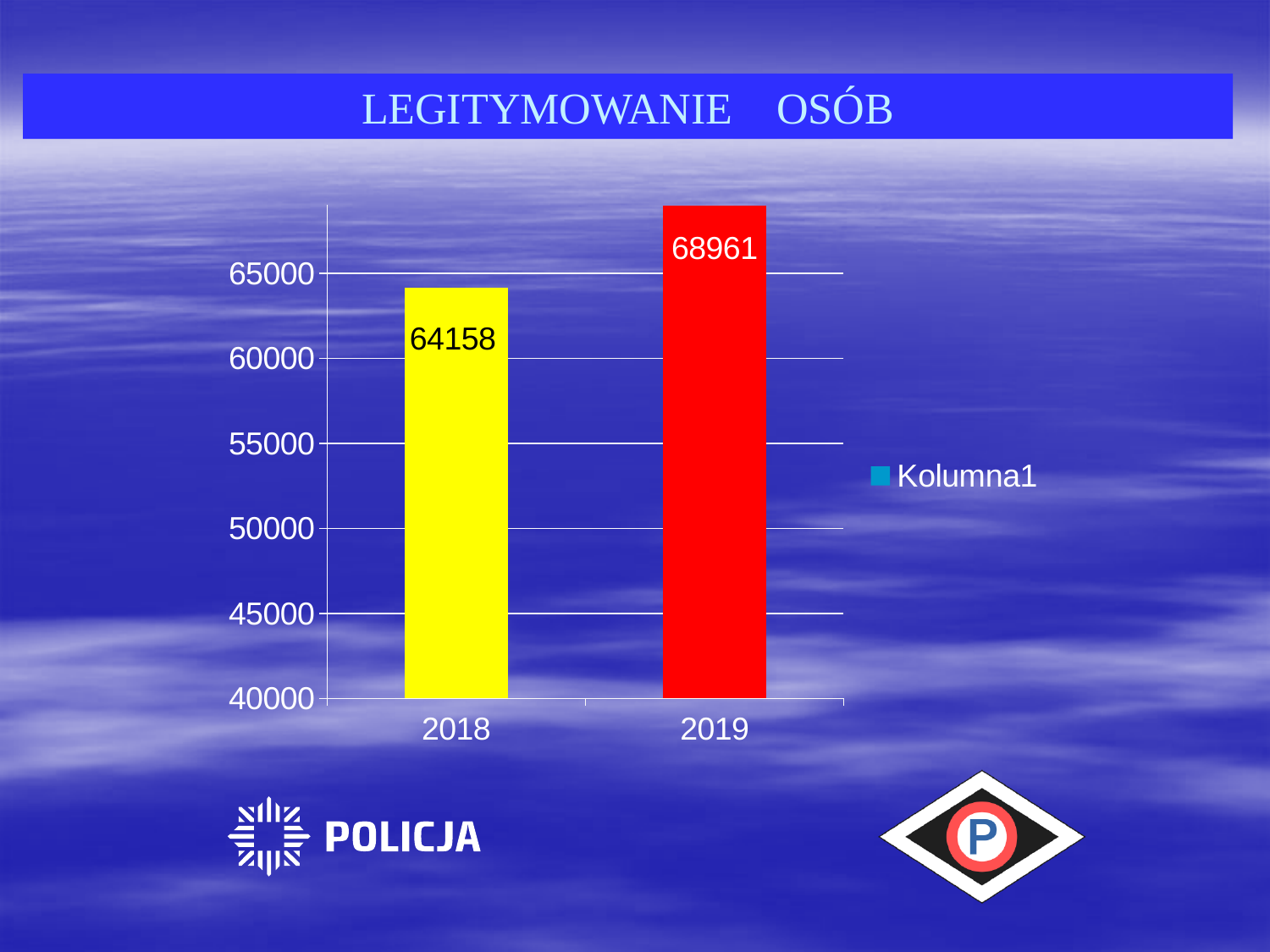
Which year has the lower value? 2018 Is the value for 2019 greater or less than 65000? greater Which year has the higher value? 2019 What is the title of the slide? LEGITYMOWANIE OSÓB What kind of chart is shown on the slide? bar chart Do the values rise or fall from 2018 to 2019? rise What is the difference between the 2019 and 2018 values? 4803 How many series does the legend list? 1 How many categories are shown on the x axis? 2 Is the value for 2018 greater or less than 65000? less What is the value for 2018? 64158 What is the value for 2019? 68961